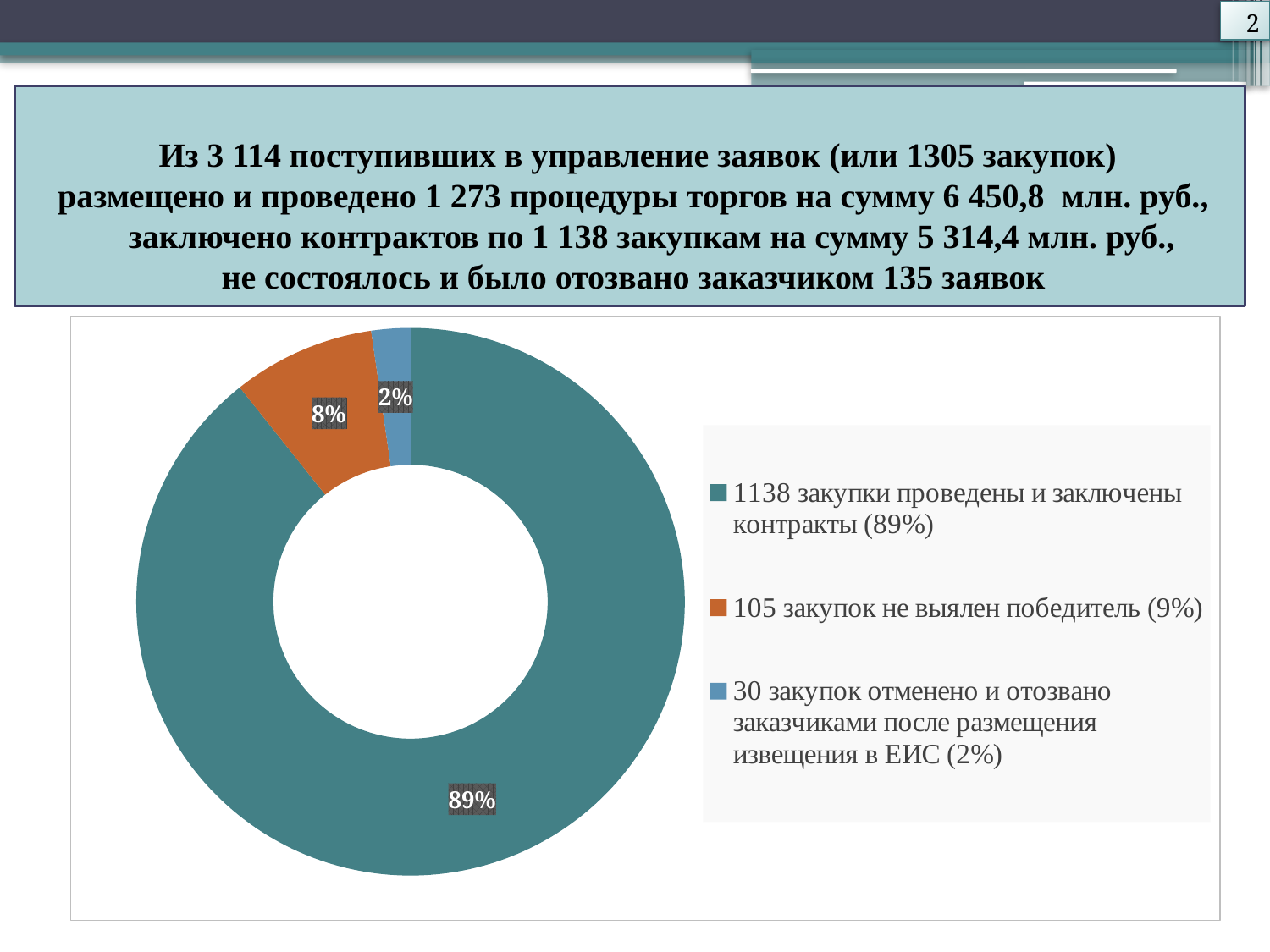
How many purchases does the legend give for the category where no winner was identified? 105 What percentage is printed on the largest slice of the chart? 89% Which legend category corresponds to the smallest slice of the chart? 30 закупок отменено и отозвано заказчиками после размещения извещения в ЕИС (2%) How many entries does the legend of the chart list? 3 What is the difference between the percentage printed on the largest slice and the percentage printed on the orange slice? 81% Which legend category corresponds to the largest slice of the chart? 1138 закупки проведены и заключены контракты (89%) What colour is the slice representing purchases with concluded contracts? Teal (dark green-blue) What percentage is printed on the orange slice of the chart? 8% Which slice is larger: the orange slice or the blue slice? The orange slice What percentage is printed on the slice for purchases cancelled and withdrawn by customers after publication in ЕИС? 2% How many slices does the doughnut chart have? 3 What kind of chart is shown on the slide? Doughnut (pie) chart